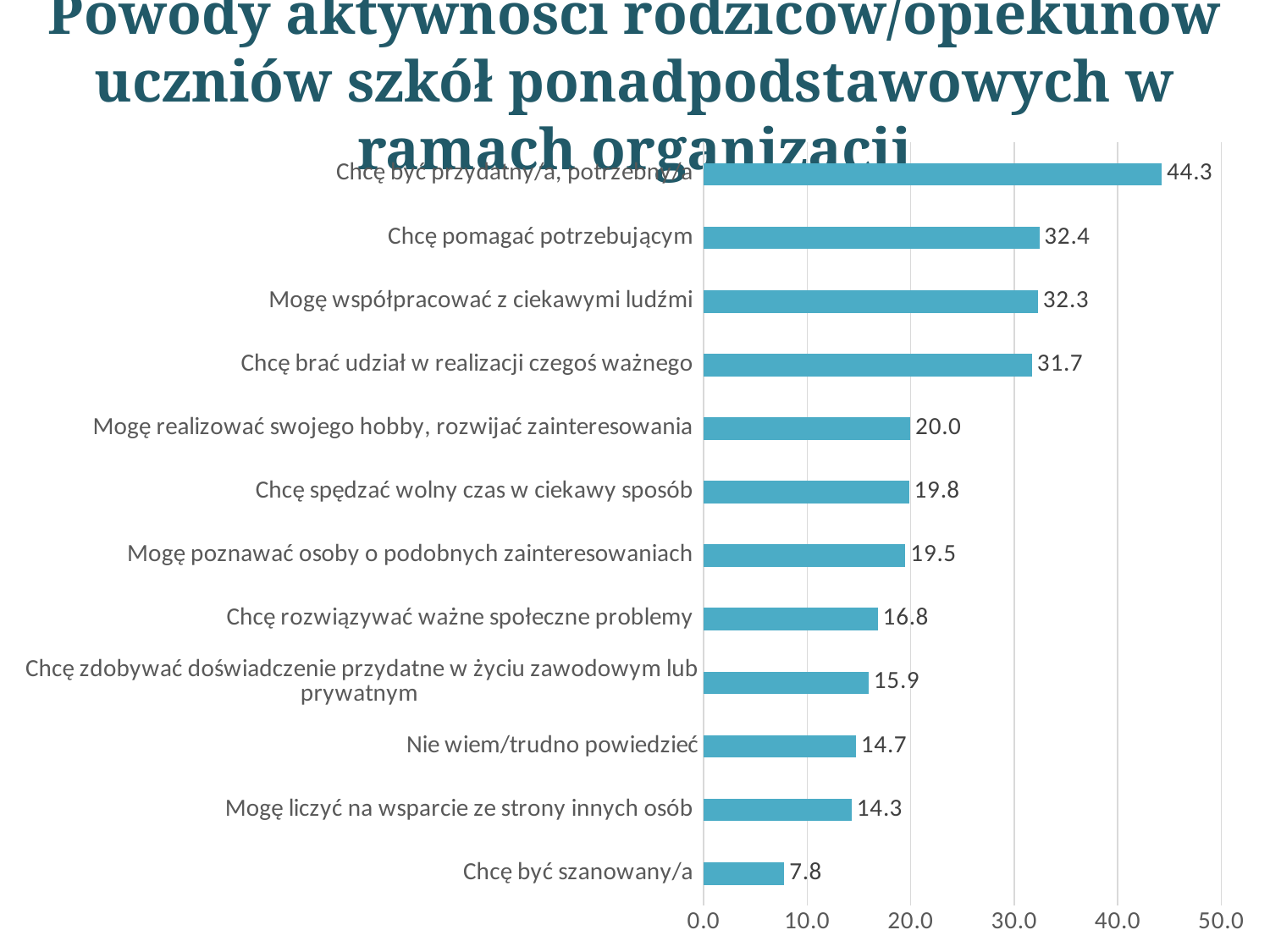
What is the value for "Nie wiem/trudno powiedzieć"? 14.7 What is the difference between the values for "Chcę brać udział w realizacji czegoś ważnego" and "Chcę rozwiązywać ważne społeczne problemy"? 14.9 What is the value of the top (highest) bar in the chart? 44.3 What is the value for "Chcę zdobywać doświadczenie przydatne w życiu zawodowym lub prywatnym"? 15.9 Which category has the lowest value? Chcę być szanowany/a What is the value for "Mogę realizować swojego hobby, rozwijać zainteresowania"? 20.0 Which is larger: the value for "Chcę spędzać wolny czas w ciekawy sposób" or for "Mogę liczyć na wsparcie ze strony innych osób"? Chcę spędzać wolny czas w ciekawy sposób What type of chart is shown on the slide? bar chart What is the maximum value shown on the horizontal axis? 50.0 How many categories are shown in the chart? 12 What is the value for "Chcę pomagać potrzebującym"? 32.4 Is the value for "Mogę poznawać osoby o podobnych zainteresowaniach" greater or less than 20.0? less